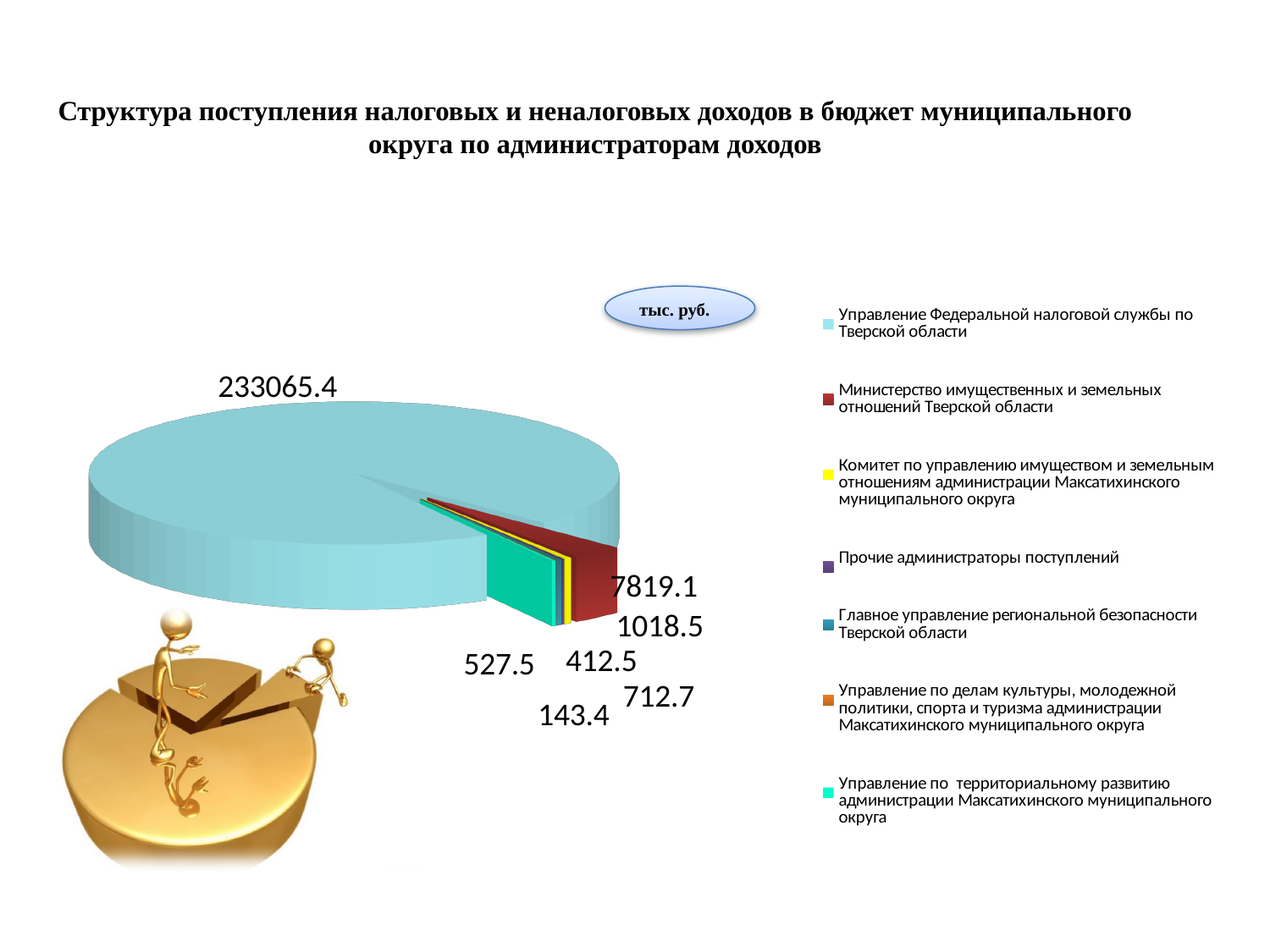
What is the value for Управление Федеральной налоговой службы по Тверской области? 233065.4 How many data labels are printed on the pie chart? 7 What is the value for Министерство имущественных и земельных отношений Тверской области? 7819.1 In what units are the chart values given? тыс. руб. Which is larger: the value for Управление Федеральной налоговой службы по Тверской области or for Министерство имущественных и земельных отношений Тверской области? Управление Федеральной налоговой службы по Тверской области Which administrator has the largest share of the pie? Управление Федеральной налоговой службы по Тверской области What colour is the slice for Управление Федеральной налоговой службы по Тверской области? light blue How many entries does the legend list? 7 What kind of chart is shown on the slide? pie chart What is the difference between the values for Управление Федеральной налоговой службы по Тверской области and Министерство имущественных и земельных отношений Тверской области? 225246.3 What is the smallest value printed on the chart? 143.4